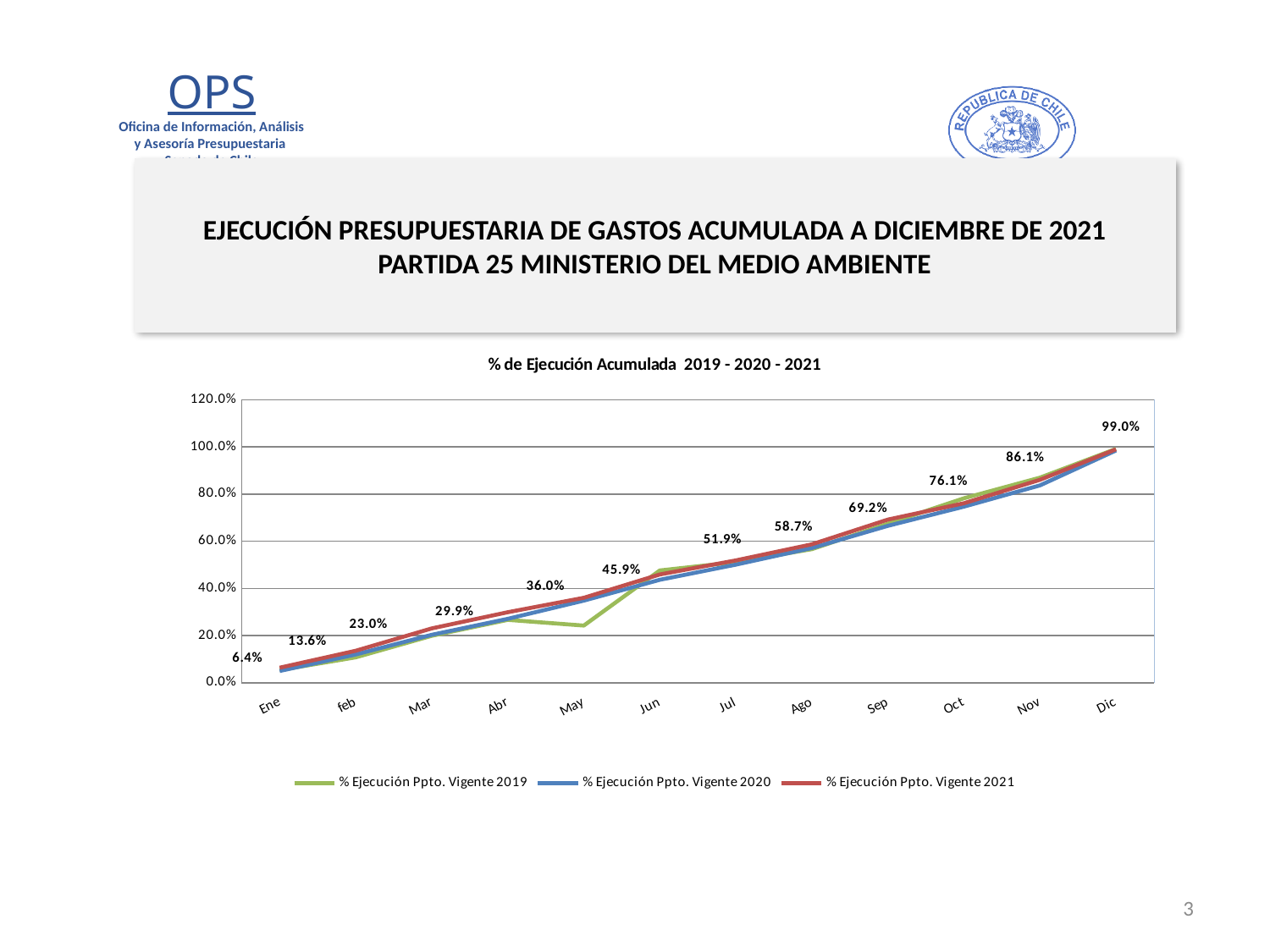
Do the values in the 2021 series rise or fall from Ene to Dic? rise How many series does the legend list? 3 Which month has the lowest labelled value in the 2021 series? Ene What is the labelled value for Ene (January) in the % Ejecución Ppto. Vigente 2021 series? 6.4% What is the title of the chart? % de Ejecución Acumulada 2019 - 2020 - 2021 What is the labelled value for Jun in the % Ejecución Ppto. Vigente 2021 series? 45.9% What type of chart is shown on the slide? line chart What is the labelled value for Sep in the % Ejecución Ppto. Vigente 2021 series? 69.2% Which month has the highest labelled value in the 2021 series? Dic How many months are plotted along the x axis? 12 What is the labelled value for Dic (December) in the % Ejecución Ppto. Vigente 2021 series? 99.0% What is the difference between the labelled values for Nov (86.1%) and Oct (76.1%) in the 2021 series? 10.0%